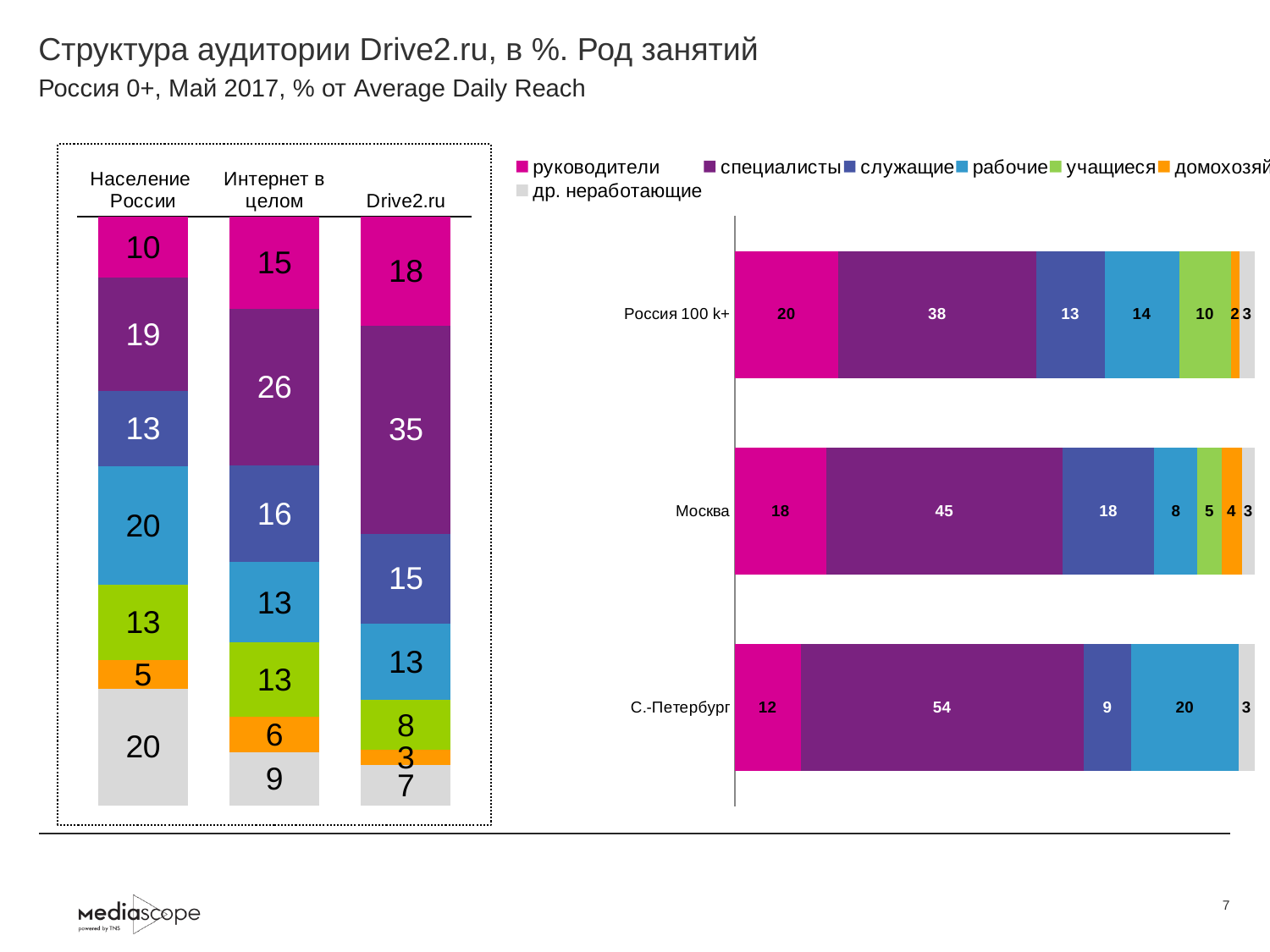
In the right chart, what is the value of рабочие for Москва? 8 In the left chart, which of the three bars has the largest специалисты segment? Drive2.ru In the left chart, what is the difference between the специалисты values for Drive2.ru and Население России? 16 In the right chart, what is the value of специалисты for С.-Петербург? 54 How many bars does the right chart show? 3 In the left chart, what is the value of the top (руководители) segment for Население России? 10 In the left chart, what is the share of специалисты for Drive2.ru? 35 What type of chart is the left chart? Stacked bar chart How many series does the legend of the right chart list? 7 In the left chart, what is the value of the bottom (др. неработающие) segment for Интернет в целом? 9 In the right chart, which region has the highest руководители value? Россия 100 k+ In the right chart, is the служащие value larger for Москва or for С.-Петербург? Москва